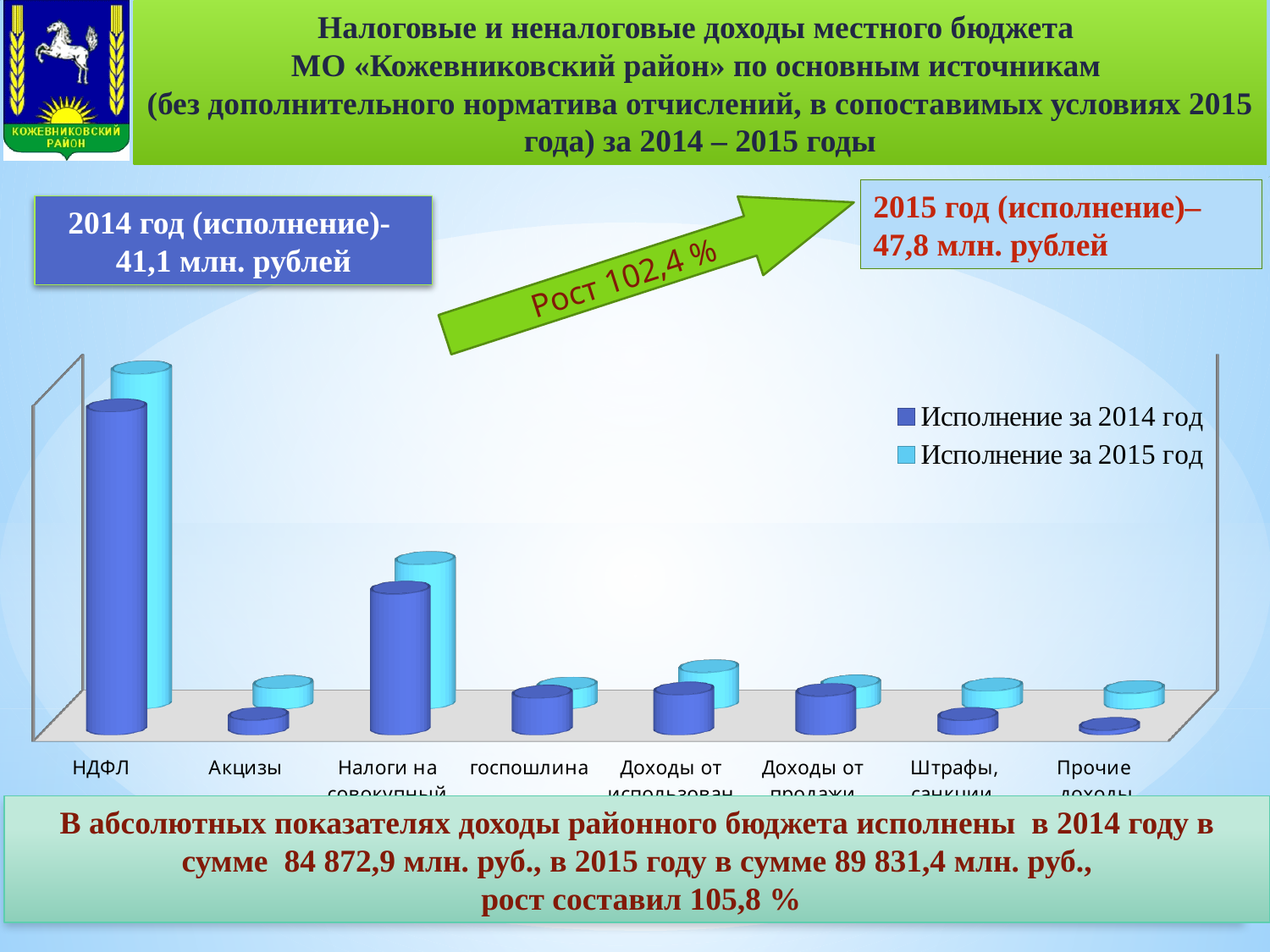
What kind of chart is shown on the slide? Bar chart For Акцизы, which is larger: Исполнение за 2014 год or Исполнение за 2015 год? Исполнение за 2015 год Which category has the second highest value for Исполнение за 2015 год? Налоги на совокупный доход Which category has the highest value for Исполнение за 2015 год? НДФЛ What are the two legend entries of the chart? Исполнение за 2014 год; Исполнение за 2015 год For Налоги на совокупный доход, which is larger: Исполнение за 2014 год or Исполнение за 2015 год? Исполнение за 2015 год How many categories are shown along the x axis of the chart? 8 Which category has the highest value for Исполнение за 2014 год? НДФЛ For НДФЛ, which is larger: Исполнение за 2014 год or Исполнение за 2015 год? Исполнение за 2015 год How many series does the chart legend list? 2 Which colour represents Исполнение за 2015 год in the chart? Light blue